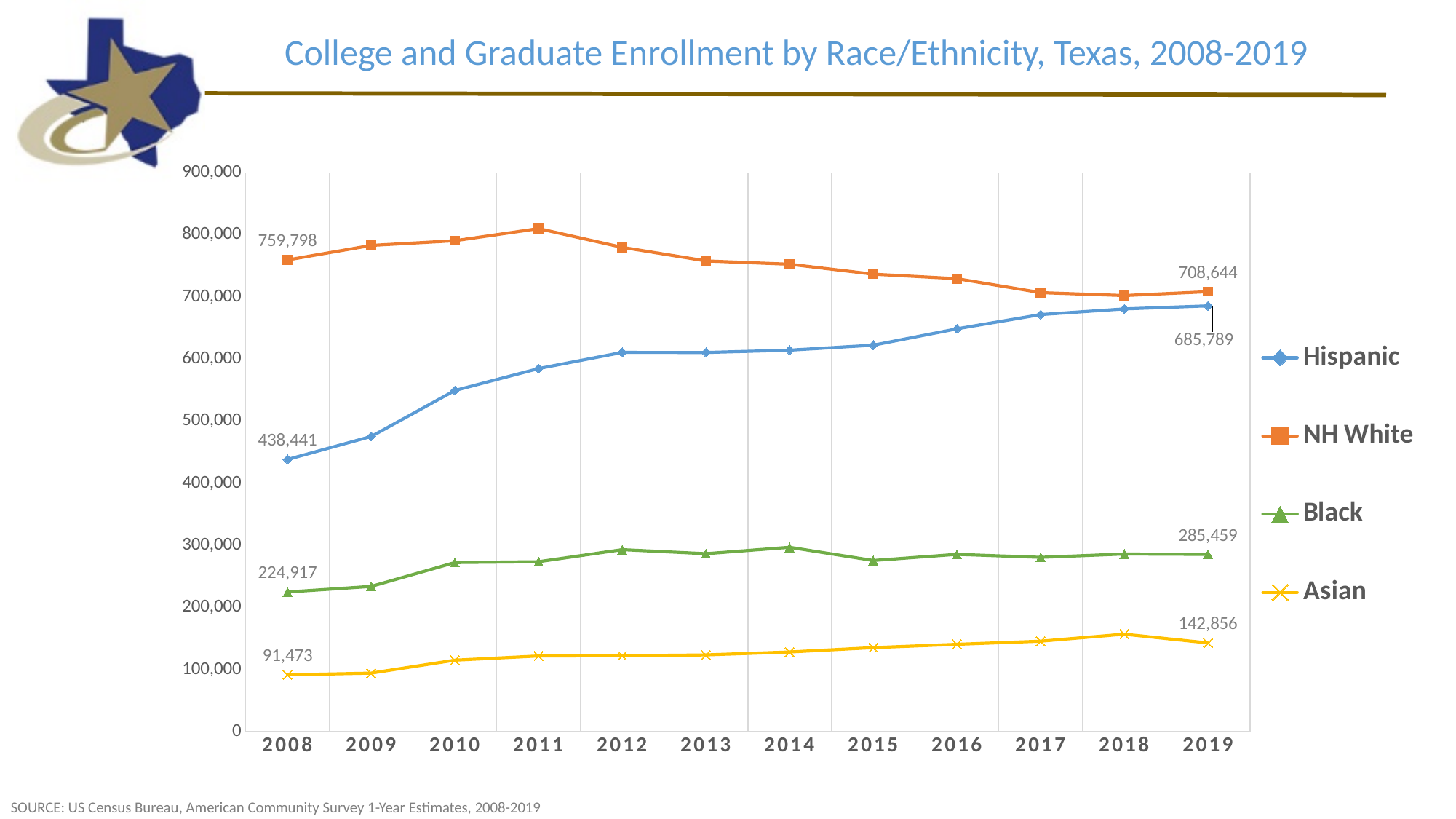
Is the Hispanic enrollment in 2012 greater or less than 500,000? greater Which was larger in 2019, Black enrollment or Asian enrollment? Black What was the Black enrollment in 2019? 285,459 Which series had the lowest enrollment in 2008? Asian Which series had the highest enrollment in 2019? NH White What kind of chart is shown on the slide? Line chart What was the Asian enrollment in 2008? 91,473 By how much did Hispanic enrollment increase from 2008 to 2019? 247,348 What was the NH White enrollment in 2008? 759,798 How many series does the legend list? 4 What was the Hispanic enrollment in 2019? 685,789 By how much did NH White enrollment decrease from 2008 to 2019? 51,154